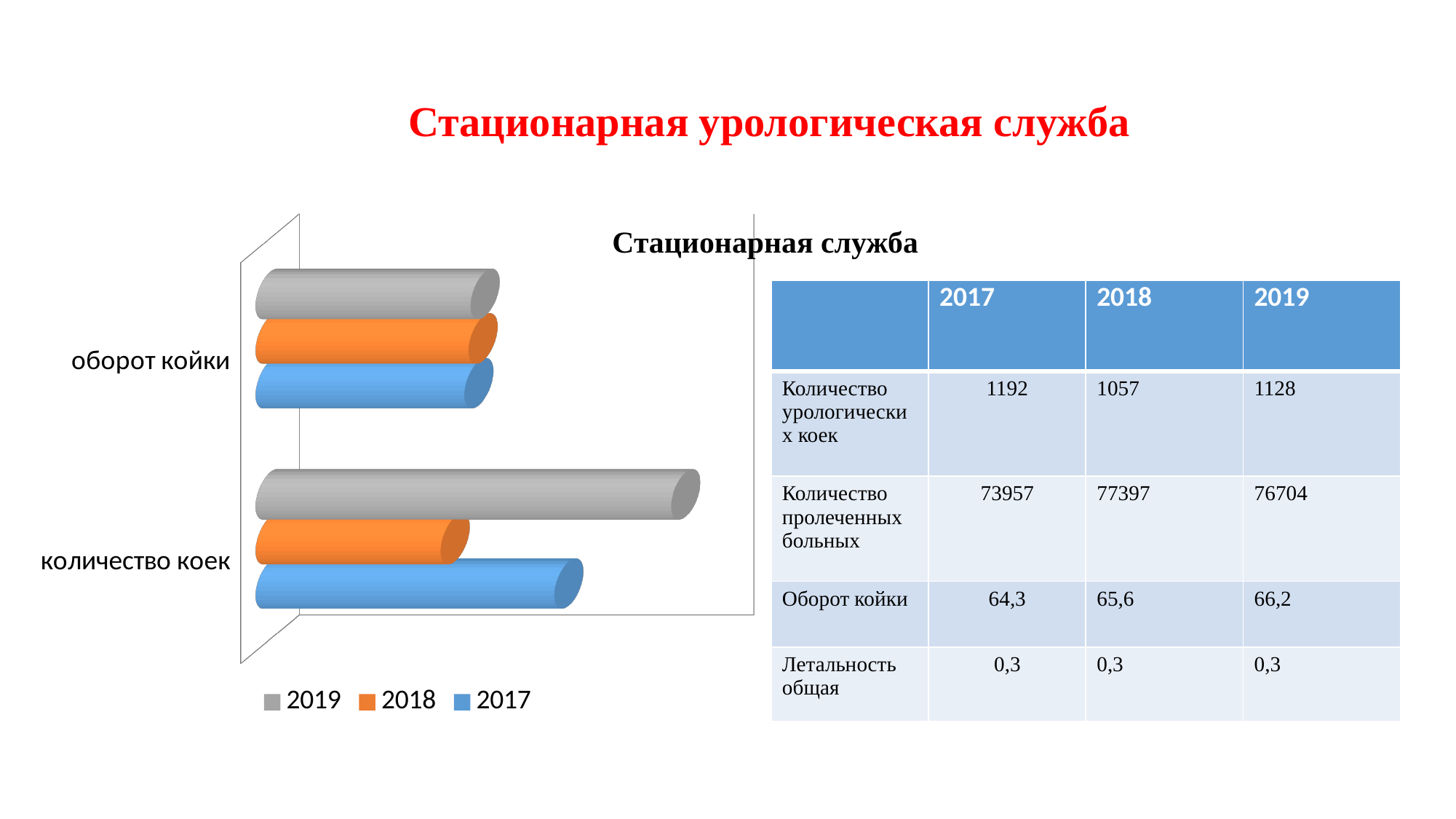
For the category 'количество коек', which series has the longest bar? 2019 Which category has the longer bar for the 2017 series: 'оборот койки' or 'количество коек'? количество коек For the category 'количество коек', which series has the shortest bar? 2018 How many series does the chart legend list? 3 What is the title of the chart? Стационарная служба For 'количество коек', is the bar for 2019 longer or shorter than the bar for 2018? longer How many categories are shown on the chart's vertical axis? 2 What kind of chart is shown on the slide? bar chart Which category has the longer bar for the 2019 series: 'оборот койки' or 'количество коек'? количество коек Which series is shown in orange in the chart legend? 2018